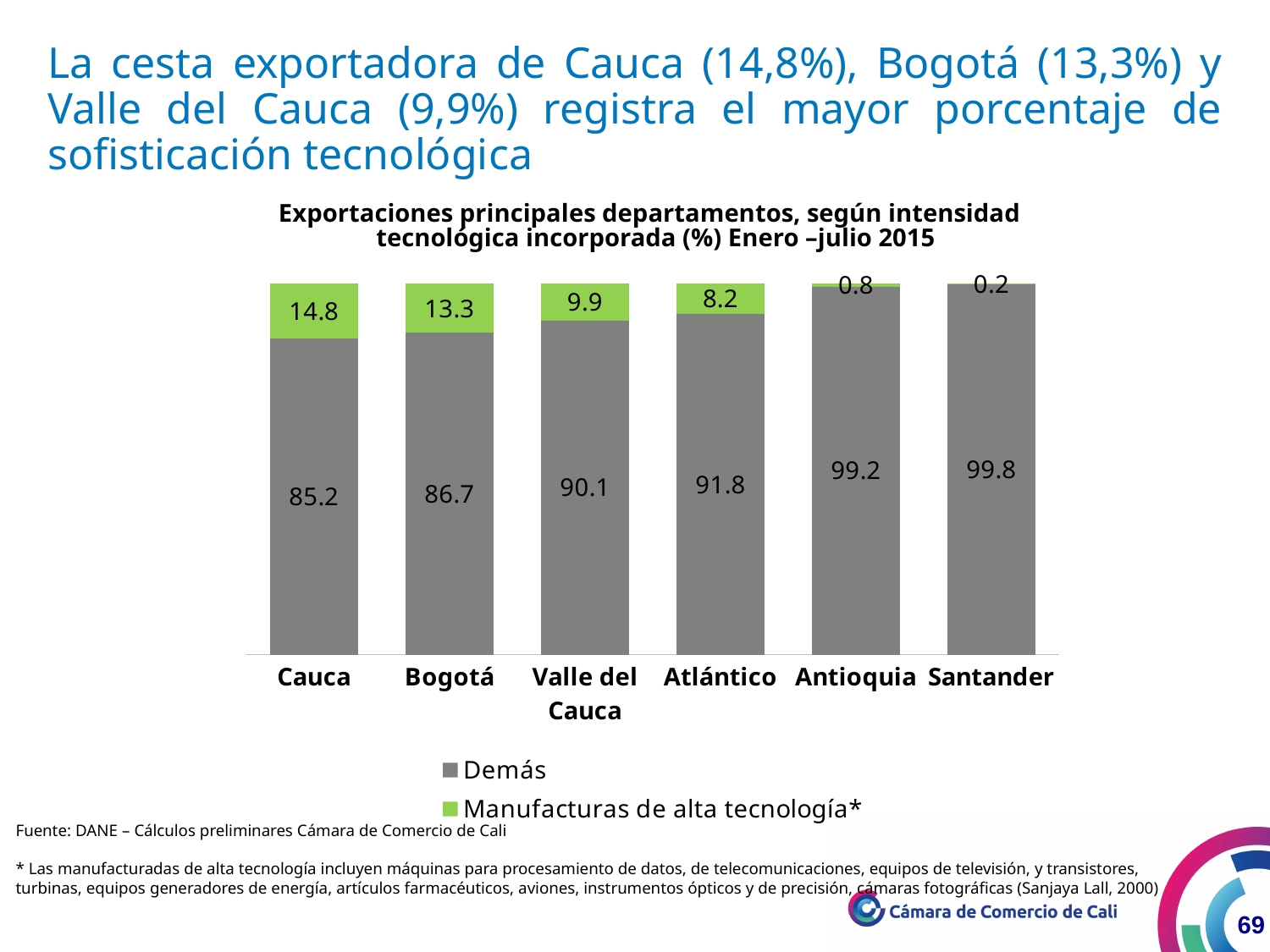
Which department has the highest value for Manufacturas de alta tecnología*? Cauca Which is larger, the Manufacturas de alta tecnología* value for Bogotá or for Atlántico? Bogotá What is the value of Demás for Antioquia? 99.2 What is the difference between the Demás values for Santander and Cauca? 14.6 How many departments are shown on the x axis? 6 What is the value of Manufacturas de alta tecnología* for Cauca? 14.8 How many series does the legend list? 2 What is the value of Manufacturas de alta tecnología* for Santander? 0.2 Which department has the lowest value for Demás? Cauca What is the total of the stacked bar for Valle del Cauca? 100 What kind of chart is shown? Stacked bar chart Do the Demás values rise or fall from Cauca to Santander along the x axis? Rise